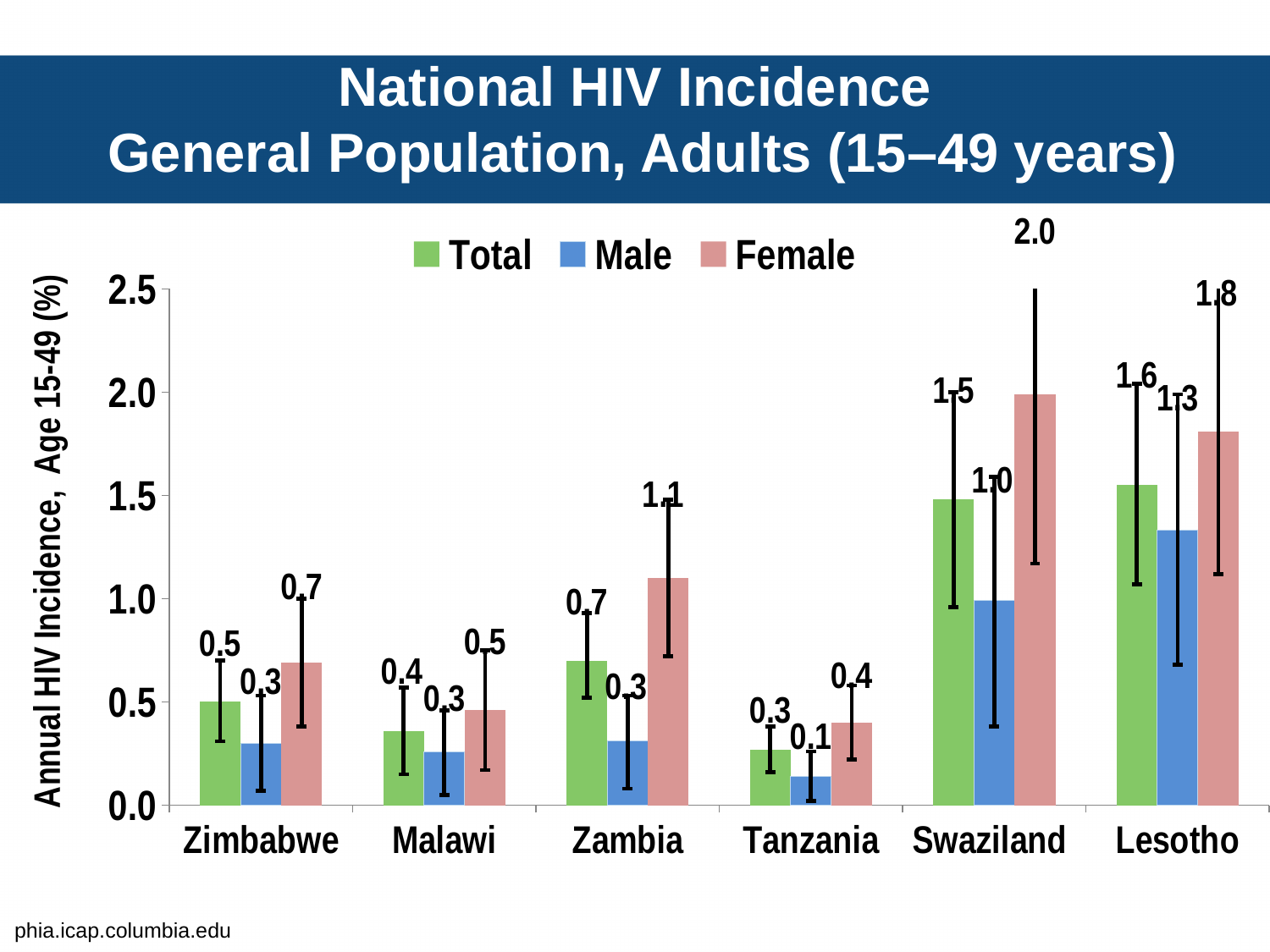
What is the difference between the Female and Male values for Zambia? 0.8 What colour represents the Male series in the legend? Blue Which country has the highest Total HIV incidence? Lesotho Which is larger, the Male value for Lesotho or the Male value for Swaziland? Lesotho How many countries are shown on the x axis? 6 What is the Male HIV incidence value for Tanzania? 0.1 How many series does the legend list? 3 Is the Female value for Lesotho greater or less than 1.5? greater What kind of chart is shown on the slide? Bar chart What is the Total HIV incidence value for Zambia? 0.7 Which country has the lowest Female HIV incidence? Tanzania What is the Female HIV incidence value for Swaziland? 2.0